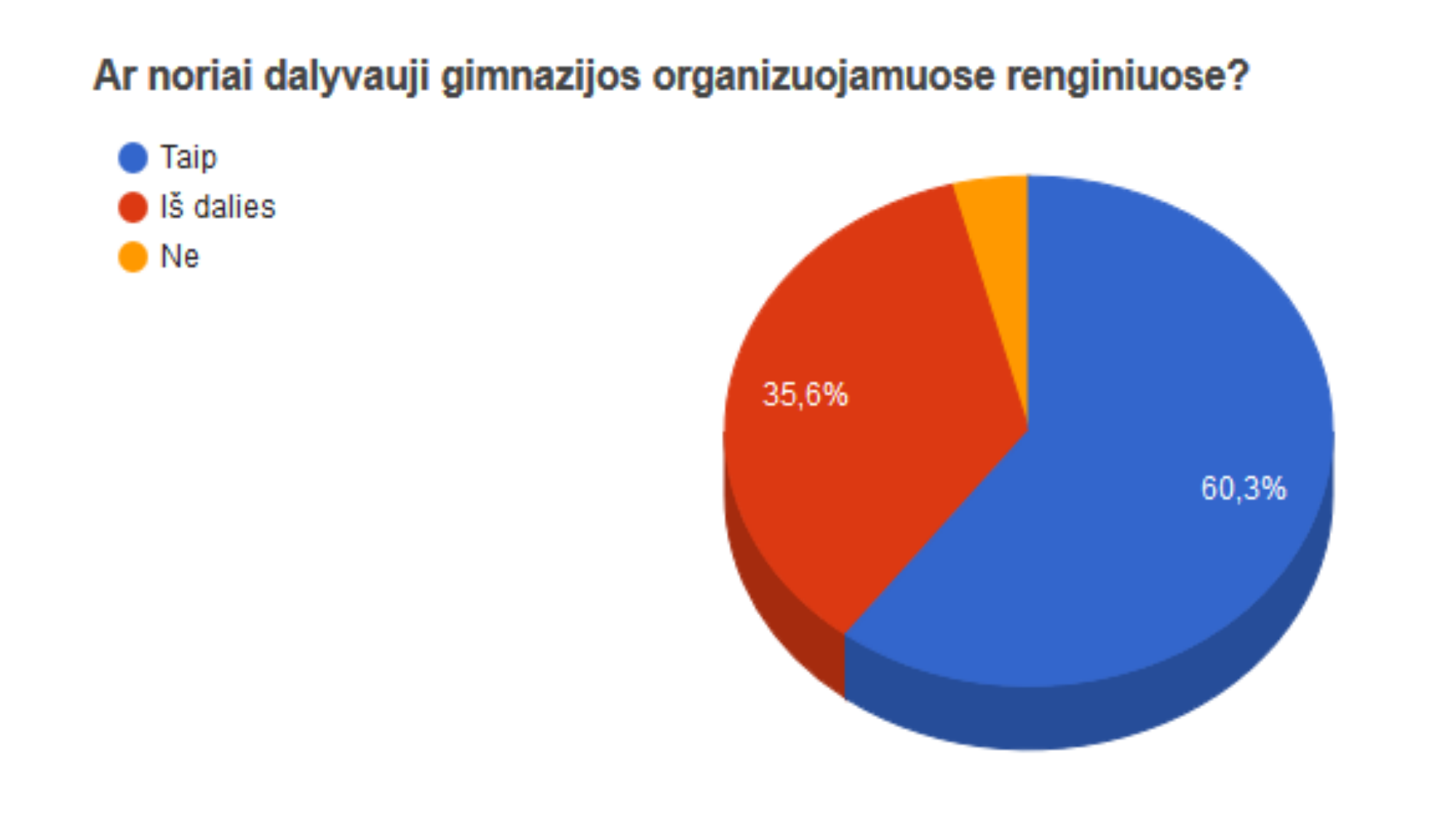
Which slice is larger, "Taip" or "Iš dalies"? Taip How many categories does the pie chart show? 3 What kind of chart is shown on the slide? Pie chart Which category has the smallest slice of the pie? Ne What share of the pie does the "Iš dalies" slice represent? 35,6% Which category has the largest slice of the pie? Taip Which slice is larger, "Iš dalies" or "Ne"? Iš dalies What is the title of the chart? Ar noriai dalyvauji gimnazijos organizuojamuose renginiuose? What colour is the "Ne" slice in the pie chart? Orange What is the difference in percentage points between the "Taip" and "Iš dalies" slices? 24,7 What share of the pie does the "Taip" slice represent? 60,3%